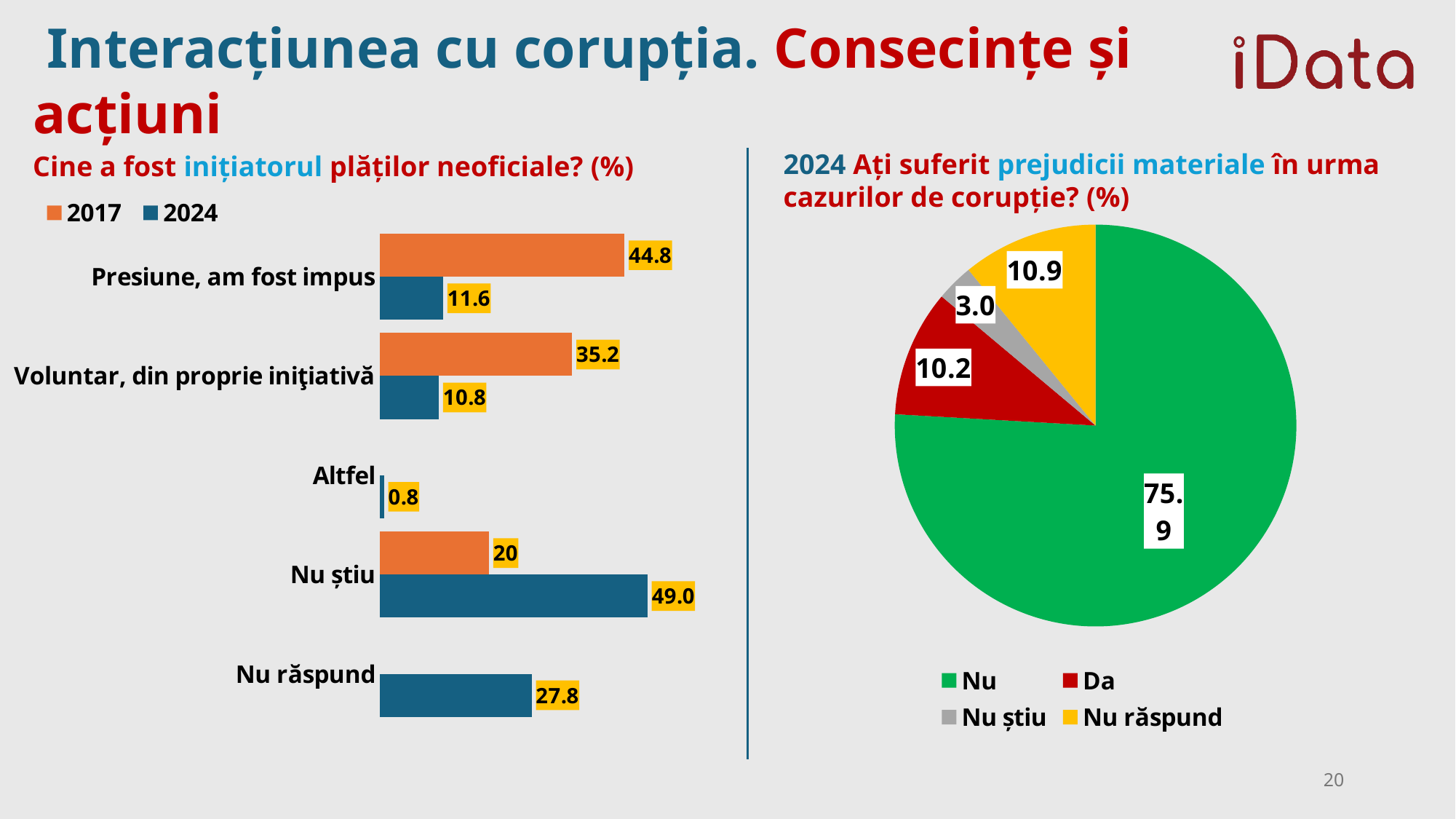
In the bar chart 'Cine a fost inițiatorul plăților neoficiale?', which is larger for 'Voluntar, din proprie inițiativă': the 2017 value or the 2024 value? 2017 In the pie chart 'Ați suferit prejudicii materiale în urma cazurilor de corupție?', which slice is the largest? Nu In the pie chart 'Ați suferit prejudicii materiale în urma cazurilor de corupție?', what is the value for 'Da'? 10.2 How many categories are shown in the bar chart 'Cine a fost inițiatorul plăților neoficiale?'? 5 In the bar chart 'Cine a fost inițiatorul plăților neoficiale?', what is the 2024 value for 'Nu răspund'? 27.8 What kind of chart is the chart on the right side of the slide? Pie chart In the bar chart 'Cine a fost inițiatorul plăților neoficiale?', which category has the lowest 2024 value? Altfel In the bar chart 'Cine a fost inițiatorul plăților neoficiale?', what is the difference between the 2017 and 2024 values for 'Presiune, am fost impus'? 33.2 In the bar chart 'Cine a fost inițiatorul plăților neoficiale?', what is the 2024 value for 'Nu știu'? 49.0 In the bar chart 'Cine a fost inițiatorul plăților neoficiale?', what is the 2017 value for 'Presiune, am fost impus'? 44.8 In the bar chart 'Cine a fost inițiatorul plăților neoficiale?', which category has the highest 2017 value? Presiune, am fost impus How many series does the legend of the bar chart 'Cine a fost inițiatorul plăților neoficiale?' list? 2